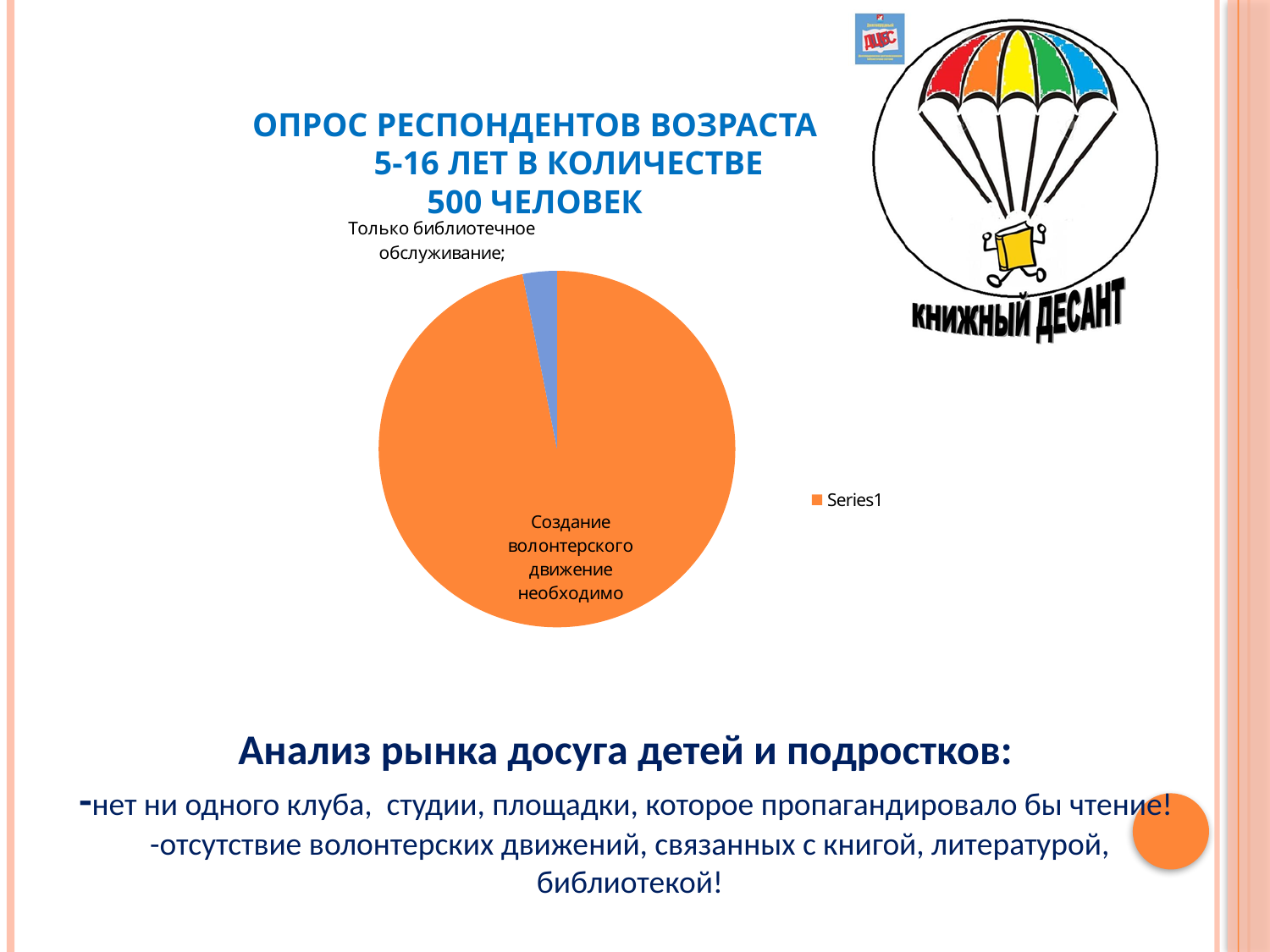
How many slices does the pie chart have? 2 Which category has the smallest slice of the pie chart? Только библиотечное обслуживание Which category has the largest slice of the pie chart? Создание волонтерского движение необходимо How many series does the legend of the pie chart list? 1 What kind of chart is shown on the slide? pie chart Which slice is larger: "Только библиотечное обслуживание" or "Создание волонтерского движение необходимо"? Создание волонтерского движение необходимо What is the name of the series shown in the chart legend? Series1 What colour is the slice for "Только библиотечное обслуживание"? blue